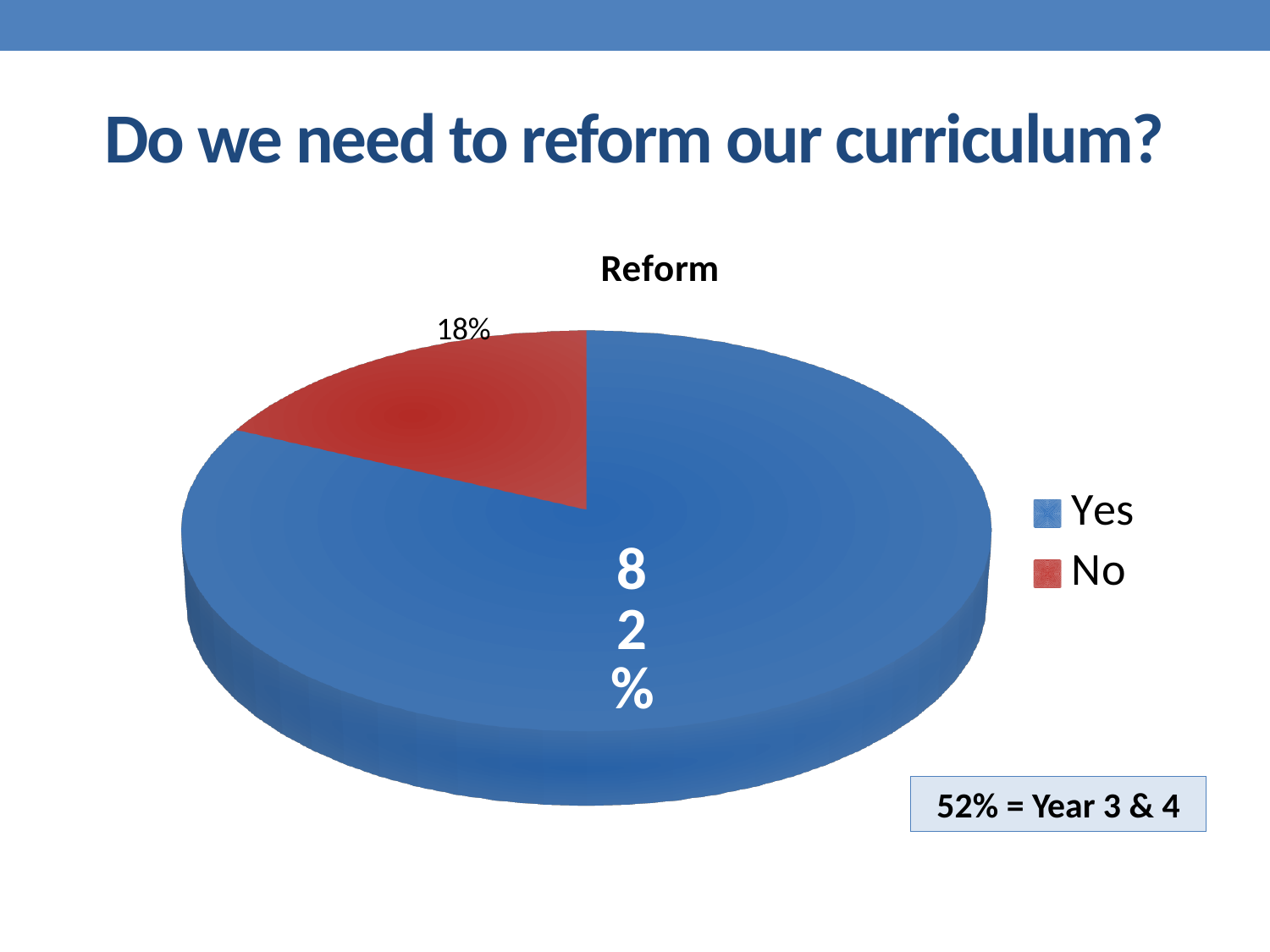
Which slice is the largest in the pie chart? Yes How many entries does the legend list? 2 What is the title of the chart? Reform Which is larger, the Yes slice or the No slice? Yes Which slice is the smallest in the pie chart? No What kind of chart is shown on the slide? pie chart What is the difference in percentage points between the Yes and No slices? 64 What percentage of the pie is the No slice? 18% How many slices does the pie chart have? 2 What colour is the No slice in the pie chart? red What percentage of the pie is the Yes slice? 82% What is the share of the pie taken by the Yes slice? 82%